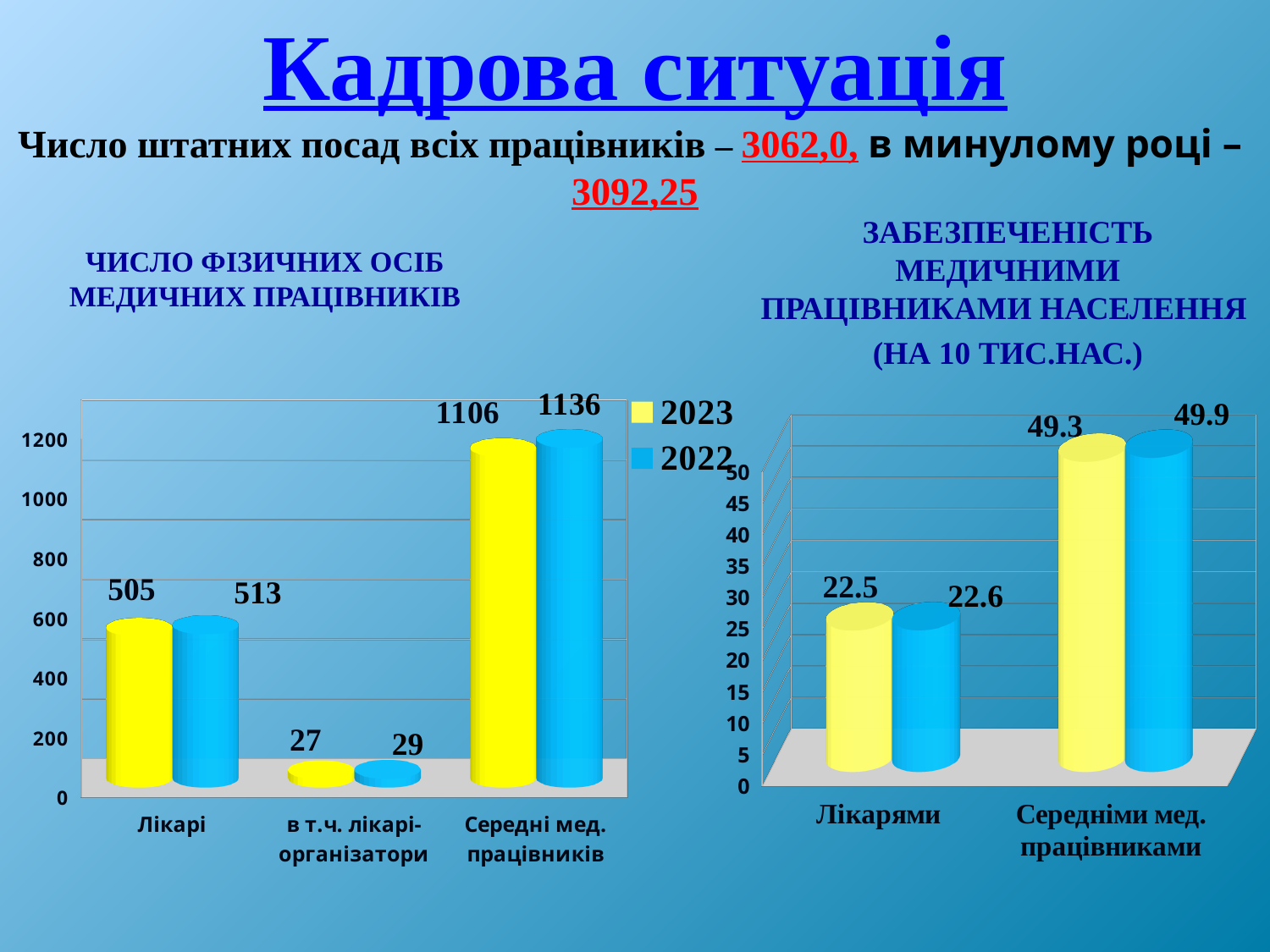
In the left chart (ЧИСЛО ФІЗИЧНИХ ОСІБ МЕДИЧНИХ ПРАЦІВНИКІВ), what is the value for Лікарі in 2023? 505 In the left chart (ЧИСЛО ФІЗИЧНИХ ОСІБ МЕДИЧНИХ ПРАЦІВНИКІВ), how many categories are shown on the x axis? 3 What kind of chart is the right chart (ЗАБЕЗПЕЧЕНІСТЬ МЕДИЧНИМИ ПРАЦІВНИКАМИ НАСЕЛЕННЯ)? bar chart In the left chart (ЧИСЛО ФІЗИЧНИХ ОСІБ МЕДИЧНИХ ПРАЦІВНИКІВ), which category has the highest value in 2022? Середні мед. працівників In the left chart (ЧИСЛО ФІЗИЧНИХ ОСІБ МЕДИЧНИХ ПРАЦІВНИКІВ), which category has the lowest value in 2023? в т.ч. лікарі-організатори In the right chart (ЗАБЕЗПЕЧЕНІСТЬ МЕДИЧНИМИ ПРАЦІВНИКАМИ НАСЕЛЕННЯ), what is the difference between the 2022 and 2023 values for Середніми мед. працівниками? 0.6 In the left chart (ЧИСЛО ФІЗИЧНИХ ОСІБ МЕДИЧНИХ ПРАЦІВНИКІВ), what is the value for Середні мед. працівників in 2022? 1136 In the left chart (ЧИСЛО ФІЗИЧНИХ ОСІБ МЕДИЧНИХ ПРАЦІВНИКІВ), what is the value for в т.ч. лікарі-організатори in 2023? 27 In the right chart (ЗАБЕЗПЕЧЕНІСТЬ МЕДИЧНИМИ ПРАЦІВНИКАМИ НАСЕЛЕННЯ), what is the value for Лікарями in 2023? 22.5 How many series does the legend list? 2 In the right chart (ЗАБЕЗПЕЧЕНІСТЬ МЕДИЧНИМИ ПРАЦІВНИКАМИ НАСЕЛЕННЯ), what is the value for Середніми мед. працівниками in 2022? 49.9 In the left chart (ЧИСЛО ФІЗИЧНИХ ОСІБ МЕДИЧНИХ ПРАЦІВНИКІВ), what is the difference between the 2022 and 2023 values for Середні мед. працівників? 30